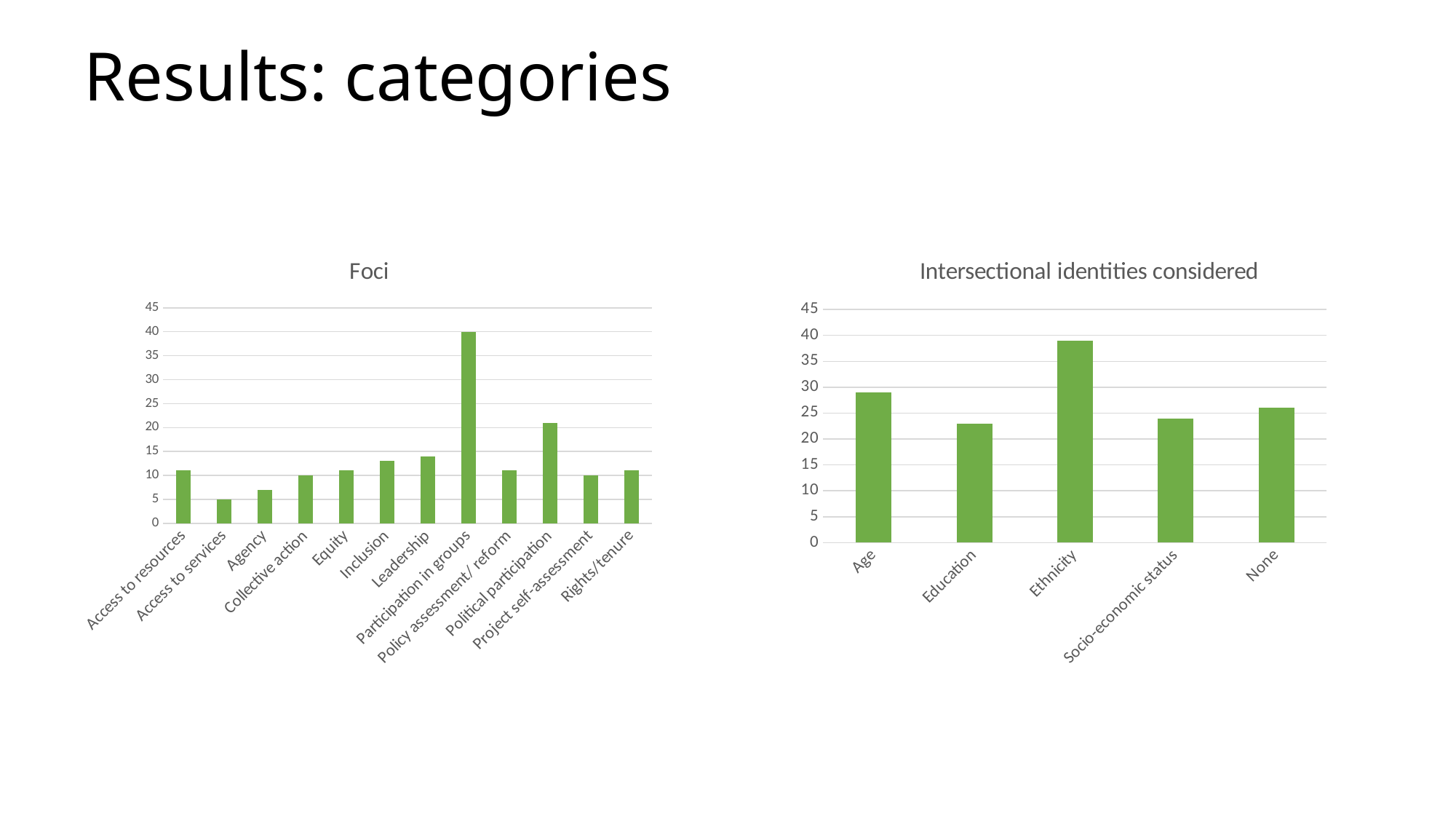
What type of chart is the "Foci" chart? bar chart In the "Foci" chart, is the value for Political participation greater or less than 15? greater In the "Foci" chart, which category has the highest value? Participation in groups How many categories are shown in the "Foci" chart? 12 In the "Foci" chart, what is the value for Participation in groups? 40 In the "Foci" chart, what is the value for Access to services? 5 In the "Intersectional identities considered" chart, which category has the highest value? Ethnicity In the "Intersectional identities considered" chart, which category has the lowest value? Education In the "Foci" chart, which is larger, Leadership or Agency? Leadership How many categories are shown in the "Intersectional identities considered" chart? 5 In the "Foci" chart, which category has the lowest value? Access to services In the "Intersectional identities considered" chart, is the value for Age greater or less than 25? greater